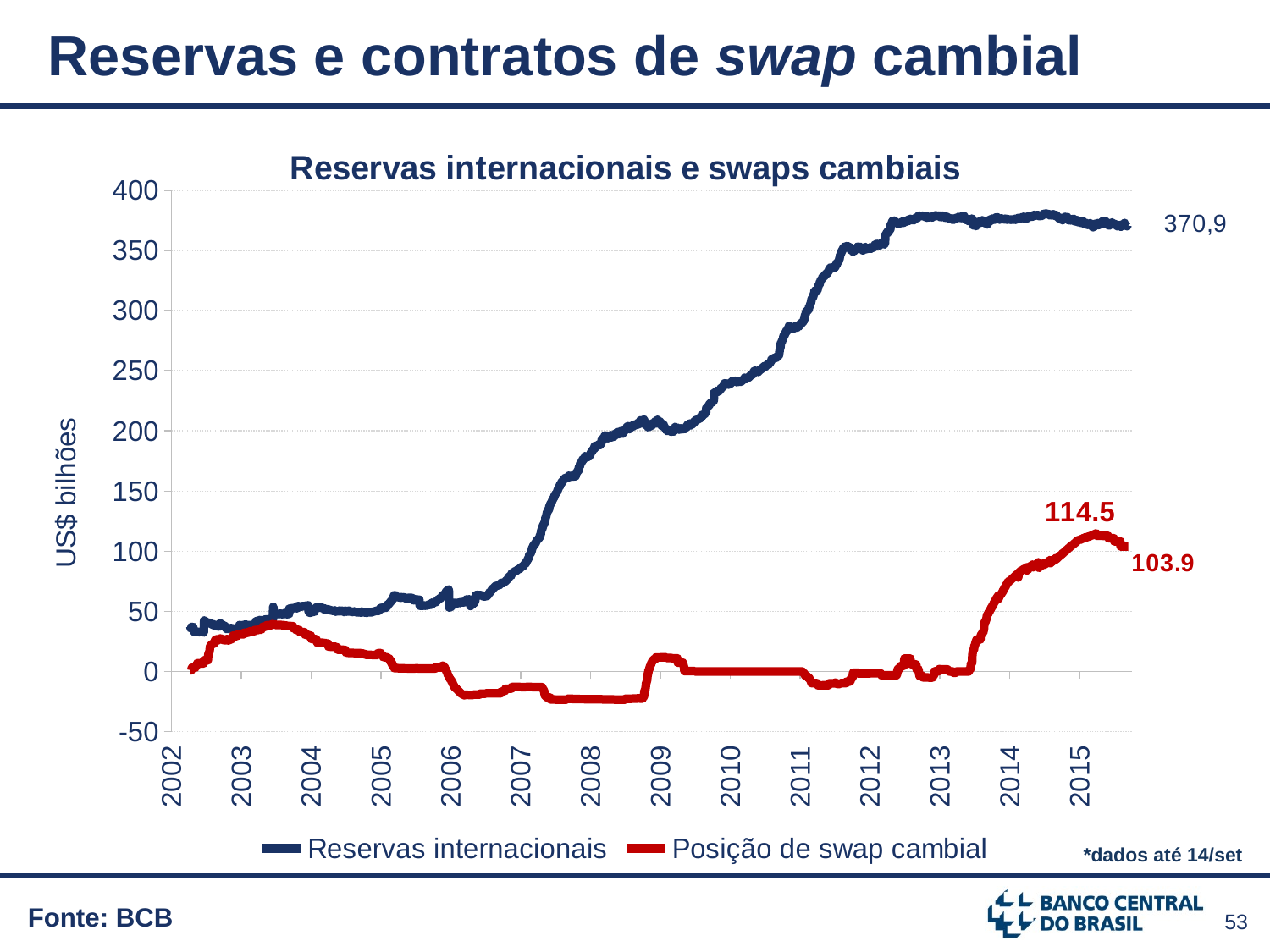
What is the latest value shown for Reservas internacionais? 370,9 What is the latest value shown for Posição de swap cambial? 103.9 What is the difference between the labelled peak of Posição de swap cambial (114.5) and its latest value (103.9)? 10.6 Does the Reservas internacionais line rise or fall overall from 2002 to 2015? rise Is the value of Reservas internacionais in 2005 greater or less than 100? less Is the value of Posição de swap cambial in 2010 greater or less than 50? less At the end of the series in 2015, which is higher: Reservas internacionais or Posição de swap cambial? Reservas internacionais What unit is shown on the vertical axis label? US$ bilhões What peak value is labelled on the Posição de swap cambial line? 114.5 Is the value of Reservas internacionais in 2008 greater or less than 150? greater What kind of chart is shown on the slide? line chart How many series does the legend list? 2